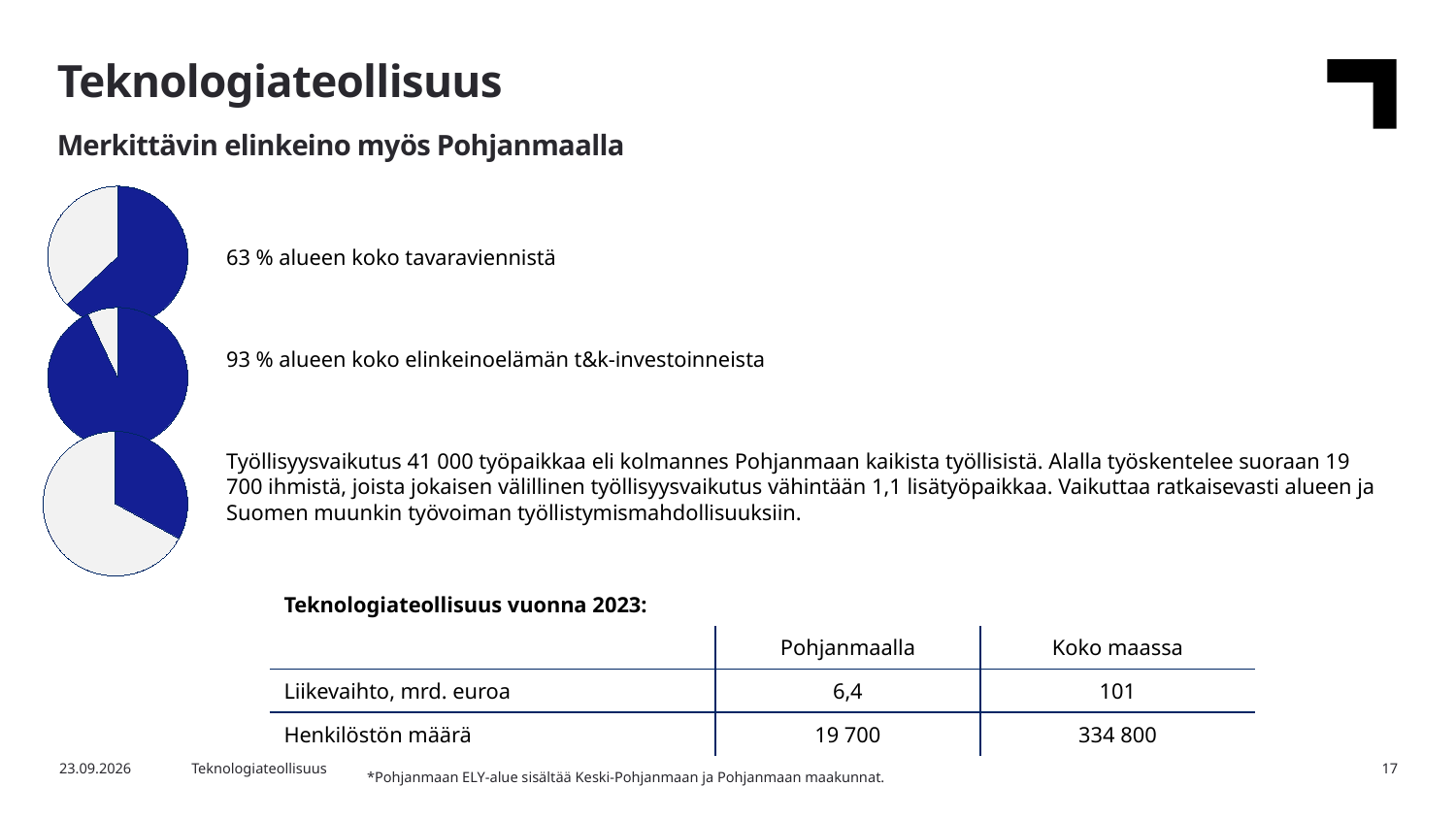
Is the blue slice in the bottom pie chart larger or smaller than half of the pie? Smaller What kind of charts are shown on the left side of the slide? Pie charts Which of the three pie charts has the largest blue slice? The middle one (93 %) Which pie chart shows a larger highlighted share: the top one (goods exports) or the middle one (R&D investments)? The middle one (R&D investments) Which of the three pie charts has the smallest blue slice? The bottom one What share of the region's total goods exports (alueen koko tavaraviennistä) does the top pie chart represent? 63 % Is the blue slice in the top pie chart larger or smaller than half of the pie? Larger What does the bottom pie chart illustrate according to the text next to it? Employment impact: a third (kolmannes) of all employed people in Pohjanmaa What share of the region's business R&D investments (elinkeinoelämän t&k-investoinneista) does the middle pie chart represent? 93 % What colour are the highlighted slices in the pie charts? Dark blue How many pie charts are on the slide? 3 By how many percentage points does the share shown by the middle pie chart (93 %) exceed the share shown by the top pie chart (63 %)? 30 percentage points